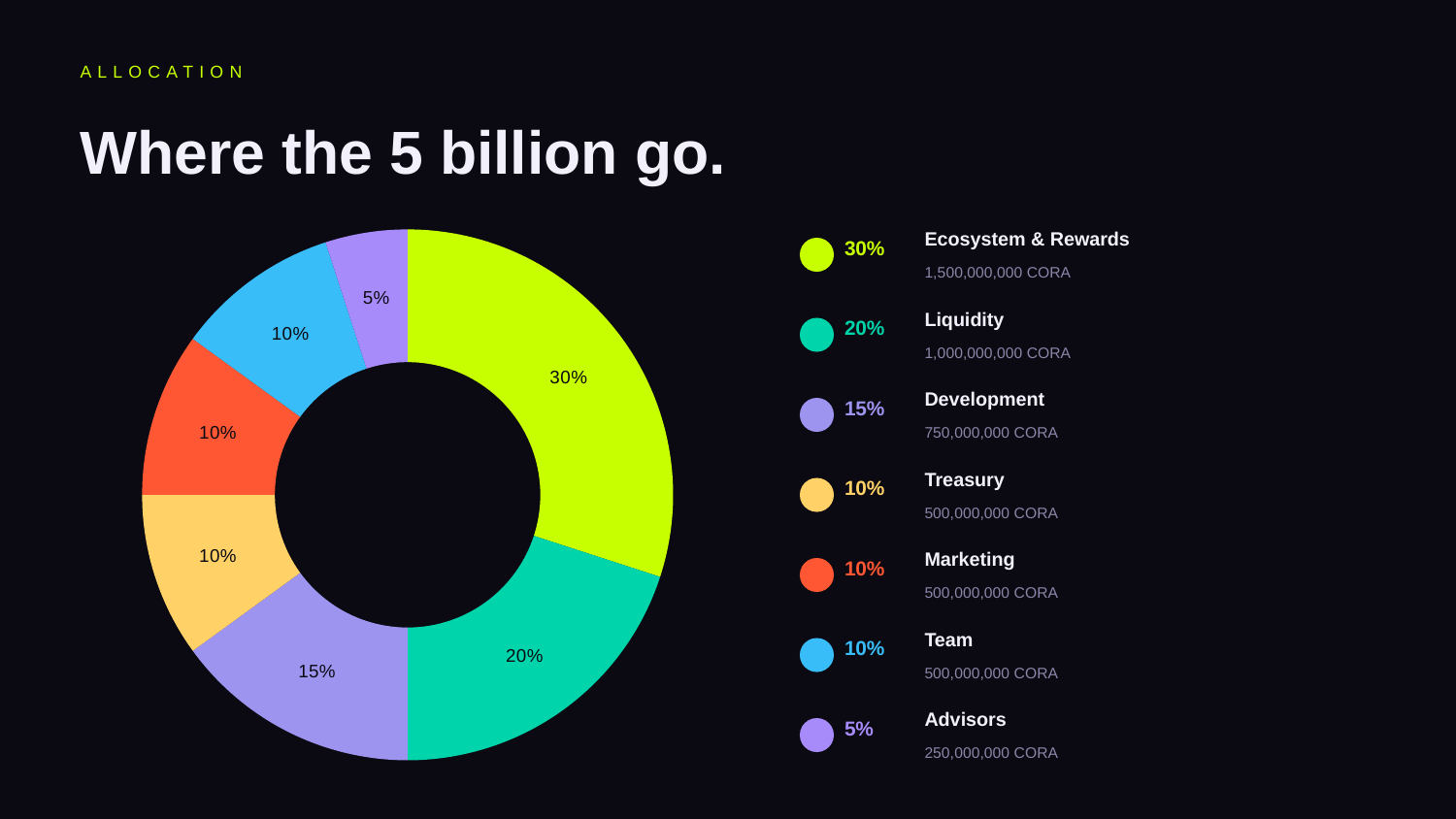
Which category receives the smallest share of the allocation? Advisors Which category receives the largest share of the allocation? Ecosystem & Rewards How many categories does the allocation chart show? 7 What share of the allocation goes to Advisors? 5% What share of the allocation goes to Ecosystem & Rewards? 30% What share of the allocation goes to Development? 15% Which is larger, the share for Development or the share for Treasury? Development What is the difference in percentage points between the Ecosystem & Rewards share and the Liquidity share? 10 percentage points What kind of chart is shown on the slide? Donut (pie) chart What is the title of the slide containing the allocation chart? Where the 5 billion go. How many CORA tokens are allocated to Development? 750,000,000 CORA